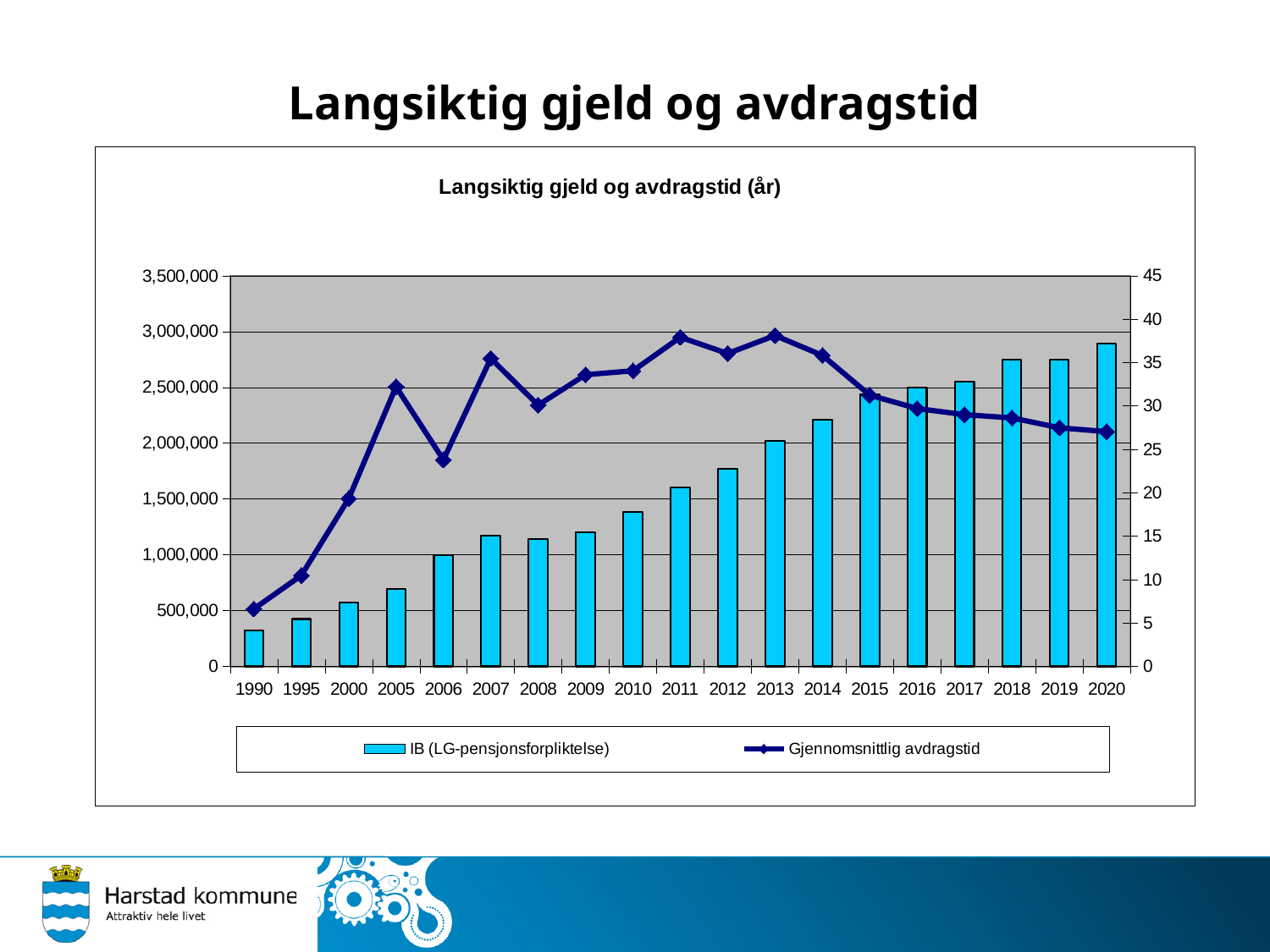
Is the Gjennomsnittlig avdragstid value for 2006 greater or less than 25? less Is the Gjennomsnittlig avdragstid value for 2020 greater or less than 30? less Which year has the lowest value for Gjennomsnittlig avdragstid? 1990 What kind of chart is shown on the slide? Combined bar and line chart Which year has the highest bar for IB (LG-pensjonsforpliktelse)? 2020 Which year has the lowest bar for IB (LG-pensjonsforpliktelse)? 1990 Is the IB (LG-pensjonsforpliktelse) bar for 2014 greater or less than 2,000,000? greater Does the Gjennomsnittlig avdragstid line rise or fall from 2013 to 2020? fall How many years are shown on the x axis? 19 Which year has the larger IB (LG-pensjonsforpliktelse) bar, 2010 or 2012? 2012 How many series does the legend list? 2